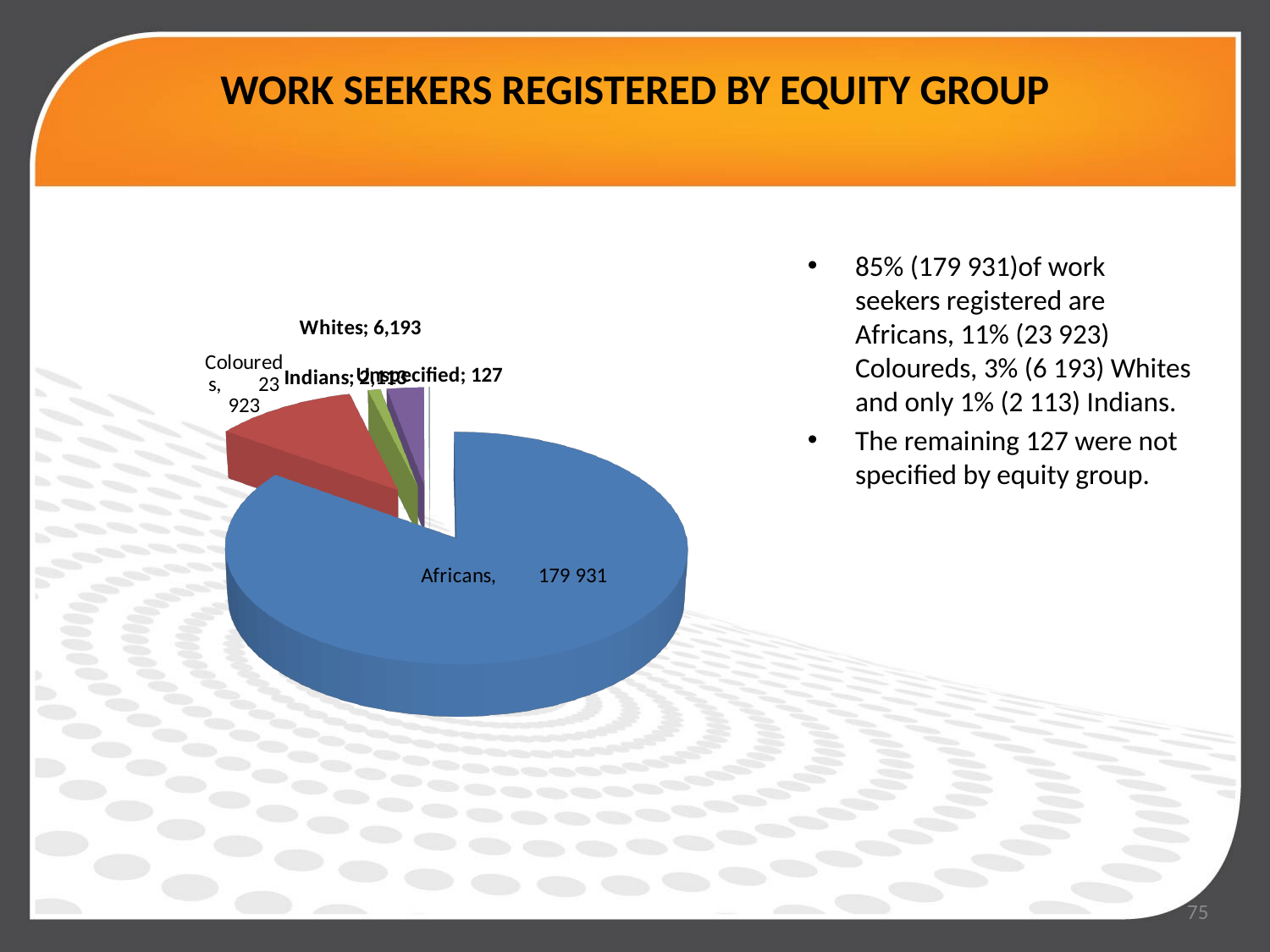
What value does the chart show for Whites? 6,193 What is the difference between the value for Africans and the value for Coloureds? 156 008 What colour is the Africans slice of the pie? blue What is the title of the chart on the slide? WORK SEEKERS REGISTERED BY EQUITY GROUP Which equity group has the smallest slice of the pie? Unspecified Which is larger, the value for Coloureds or the value for Whites? Coloureds How many slices does the pie chart have? 5 What value does the chart show for the Unspecified group? 127 What kind of chart is shown on the slide? pie chart Which equity group has the largest slice of the pie? Africans How many work seekers registered are Africans according to the chart? 179 931 What value does the chart show for Coloureds? 23 923